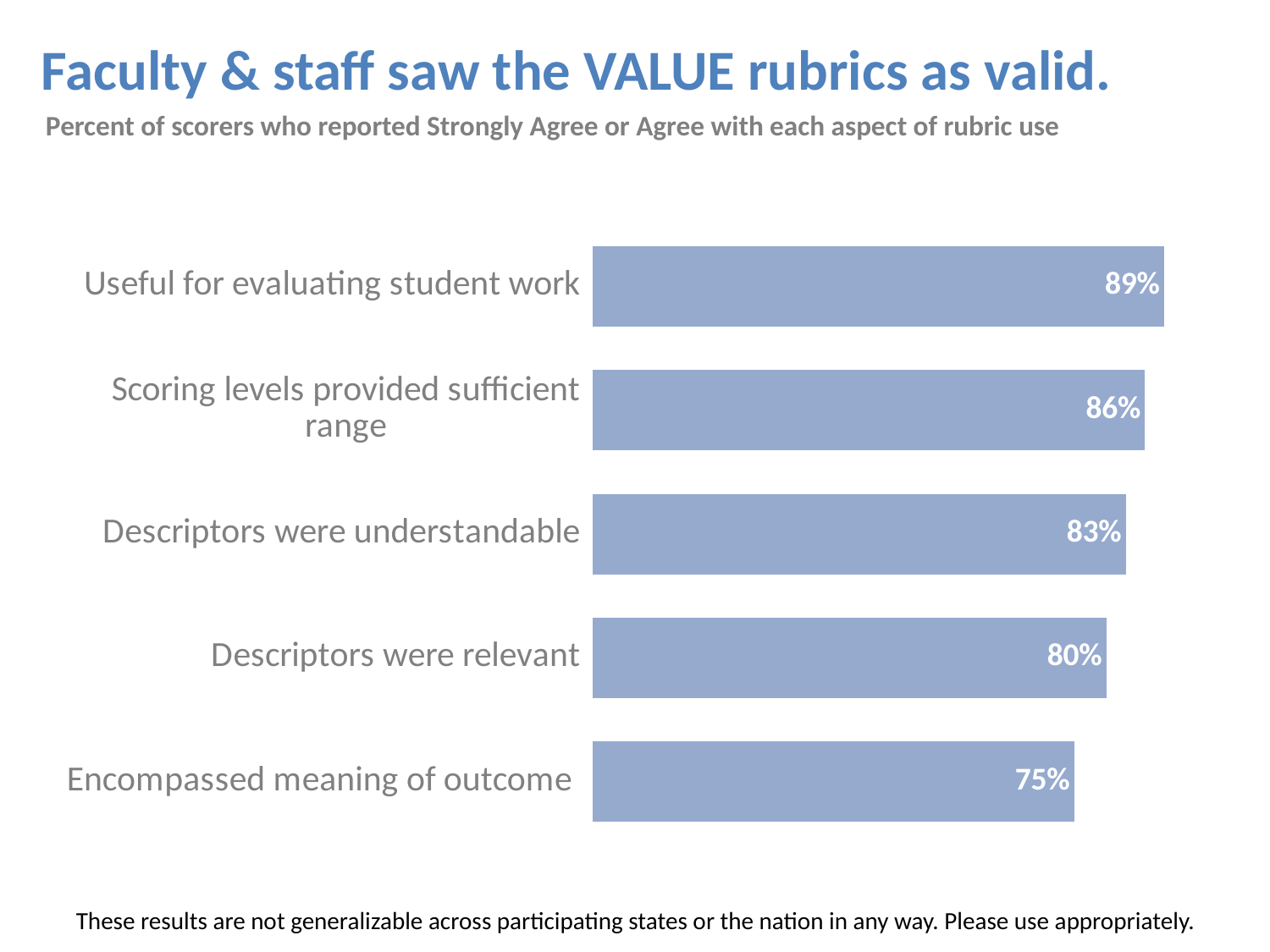
What is the value for 'Encompassed meaning of outcome'? 75% What is the value for 'Scoring levels provided sufficient range'? 86% What type of chart is shown on the slide? Bar chart How many aspects of rubric use are shown in the chart? 5 Which aspect of rubric use has the lowest percentage of agreement? Encompassed meaning of outcome What percent of scorers agreed the rubrics were useful for evaluating student work? 89% Which is larger: the value for 'Descriptors were relevant' or 'Scoring levels provided sufficient range'? Scoring levels provided sufficient range What is the difference between 'Descriptors were understandable' and 'Descriptors were relevant'? 3% What is the title of the slide? Faculty & staff saw the VALUE rubrics as valid. What is the difference in percentage points between 'Useful for evaluating student work' and 'Encompassed meaning of outcome'? 14 What percent of scorers agreed that descriptors were understandable? 83% Which aspect of rubric use has the highest percentage of agreement? Useful for evaluating student work